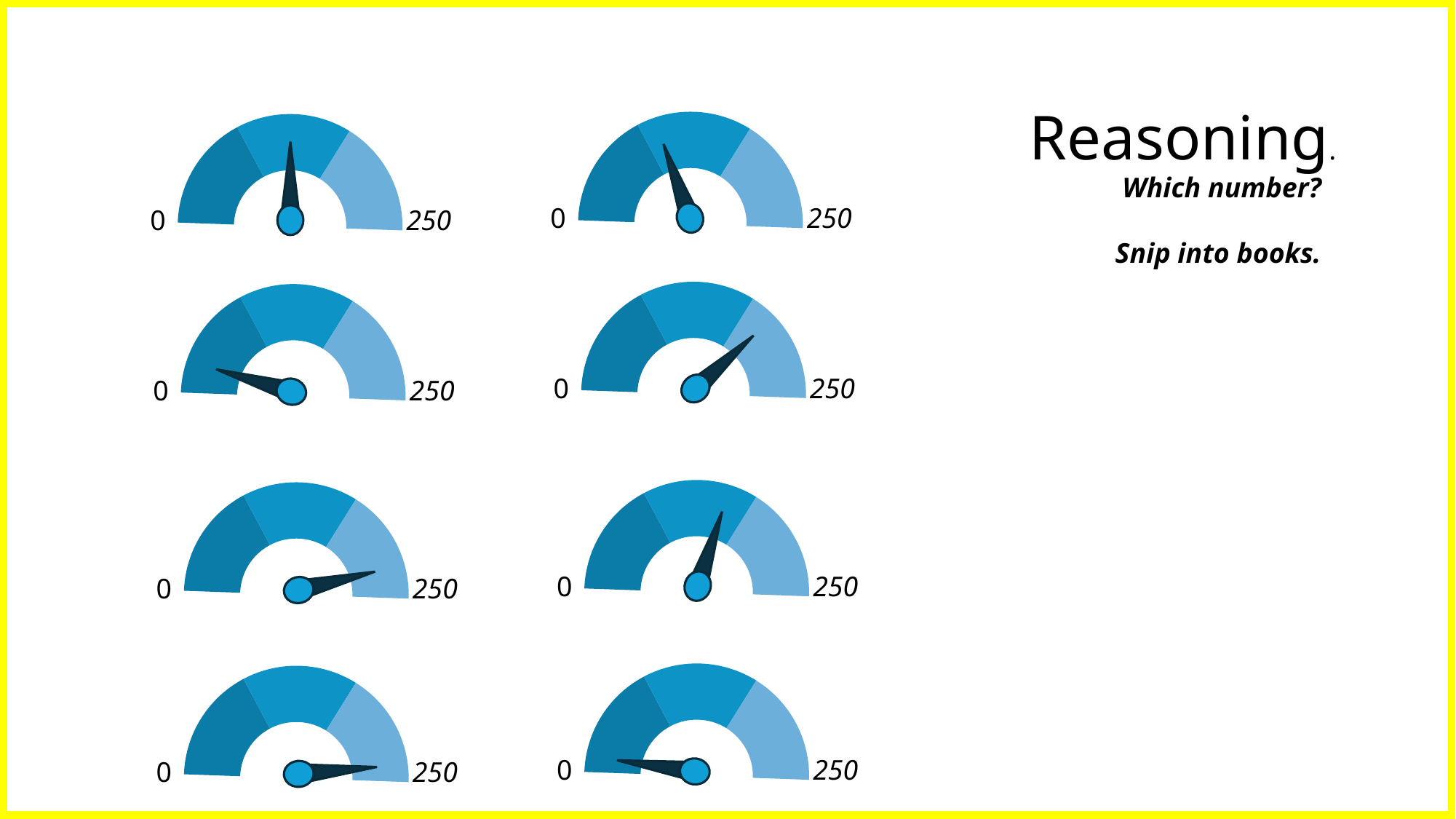
How many gauge charts are on the slide? 8 How many coloured bands does each gauge arc have? 3 What is the heading text on the right side of the slide? Reasoning. What is the lowest value printed on each gauge's scale? 0 What is the highest value printed on each gauge's scale? 250 In the second row, which gauge shows the larger value: the left one or the right one? The right one In the third row, which gauge shows the larger value: the left one or the right one? The left one What kind of chart is shown on the left side of the slide? Gauge chart Which shows a larger value: the bottom-left gauge or the top-right gauge? Bottom-left gauge